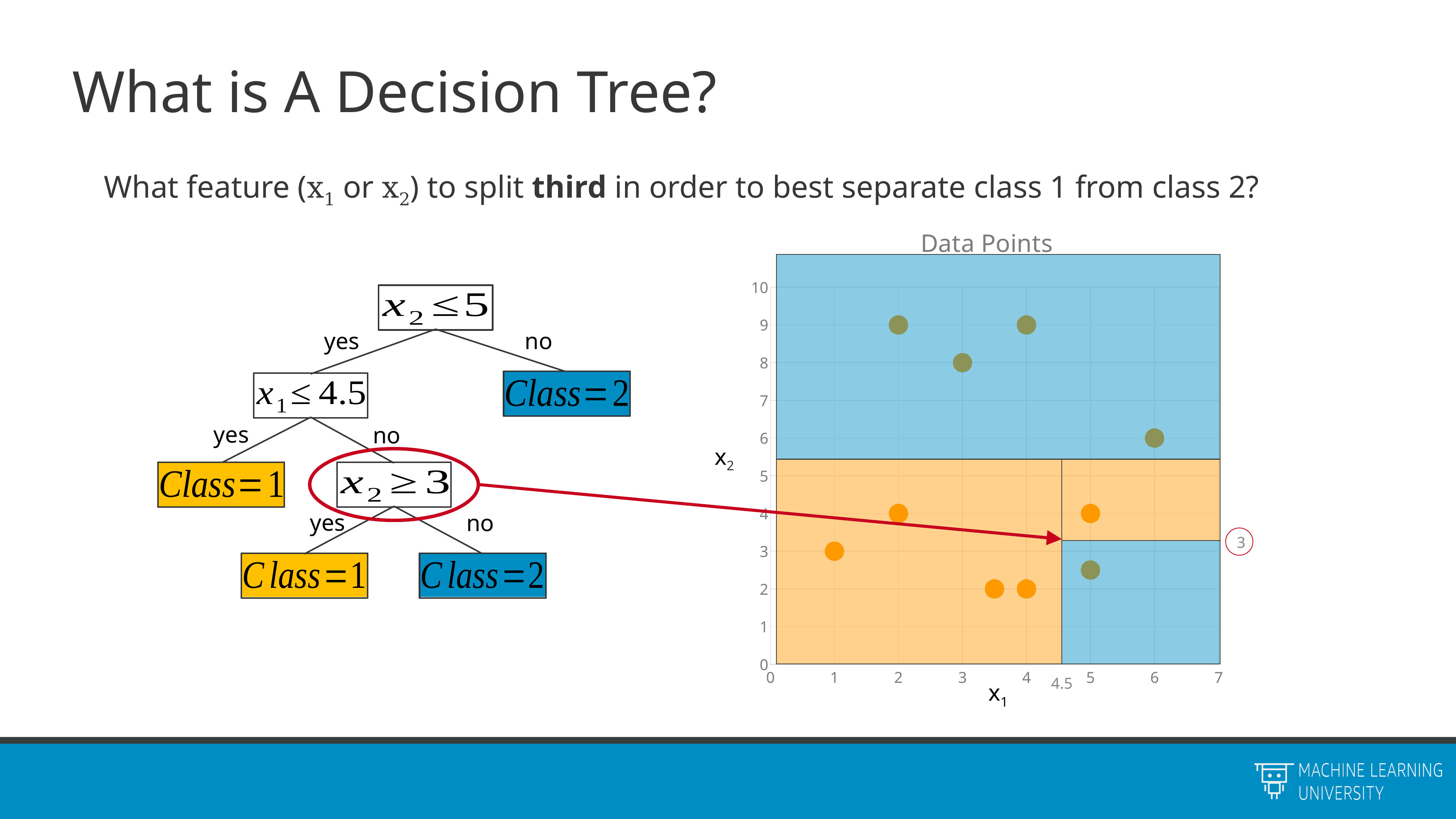
What is the title of the scatter chart on the slide? Data Points How many olive-green data points are plotted on the "Data Points" chart? 5 How many data points are plotted on the "Data Points" chart? 10 On the "Data Points" chart, what is the x2 value of the point plotted at x1 = 1? 3 On the "Data Points" chart, which point has the largest x1 value: the olive point at x2 = 6 or the orange point at x2 = 3? the olive point at x2 = 6 On the "Data Points" chart, what is the x2 value of the point plotted at x1 = 6? 6 On the "Data Points" chart, is the x2 value of the olive point at x1 = 6 greater or less than 5? greater What kind of chart is the "Data Points" chart? scatter chart How many orange data points are plotted on the "Data Points" chart? 5 What is the label of the horizontal axis on the "Data Points" chart? x1 On the "Data Points" chart, is the x1 value of the orange point at x2 = 3 greater or less than 4.5? less